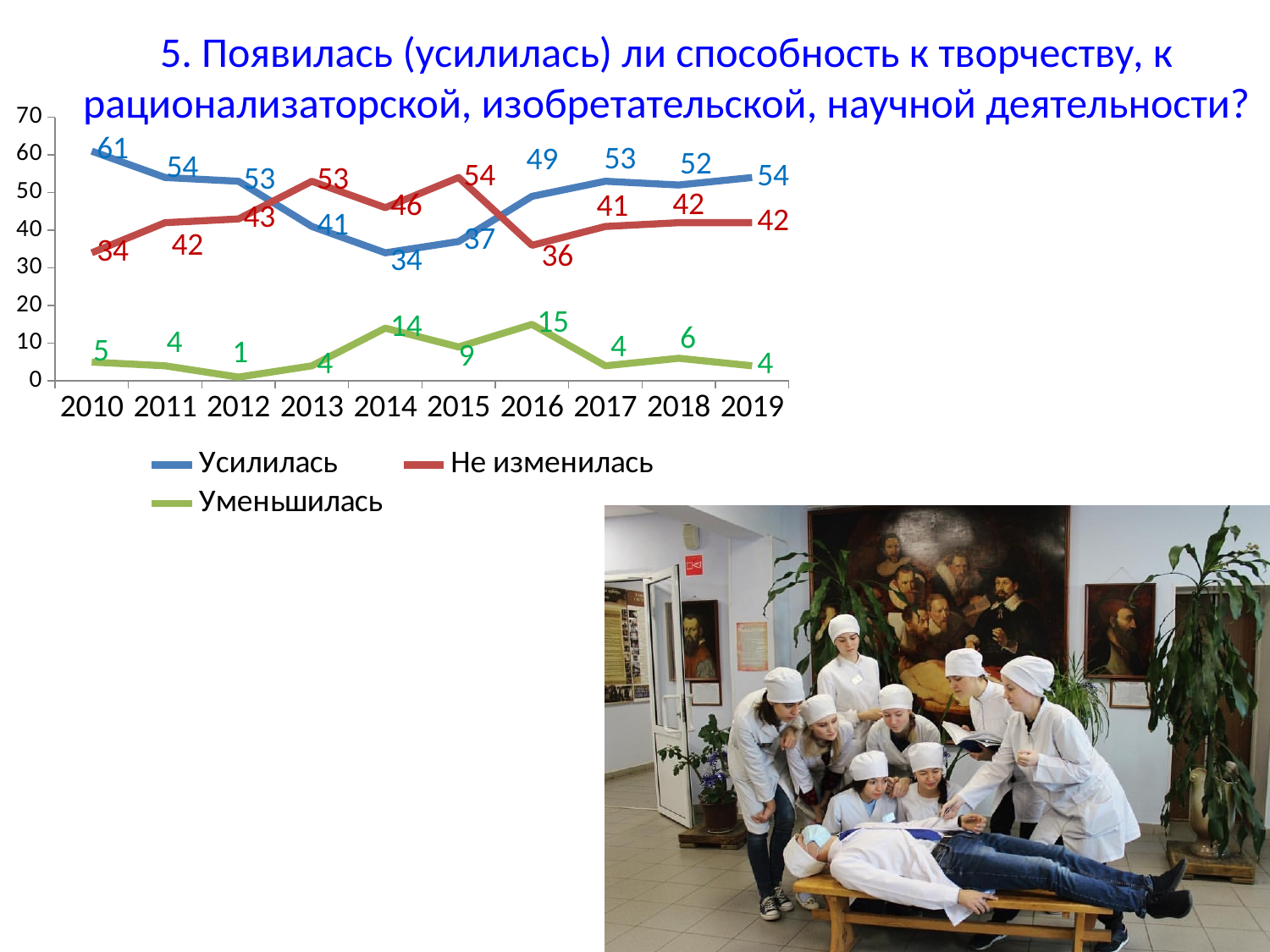
What is the value for Уменьшилась in 2016? 15 What is the difference between Усилилась and Не изменилась in 2019? 12 How many series does the legend list? 3 What is the value for Не изменилась in 2015? 54 Which series is drawn in green? Уменьшилась Does the Усилилась series rise or fall from 2010 to 2014? fall What is the value for Усилилась in 2010? 61 What type of chart is shown on the slide? line chart How many years are shown on the x axis? 10 Which is larger in 2013, Усилилась or Не изменилась? Не изменилась In which year is the Уменьшилась series at its lowest? 2012 In which year is the Усилилась series at its lowest? 2014